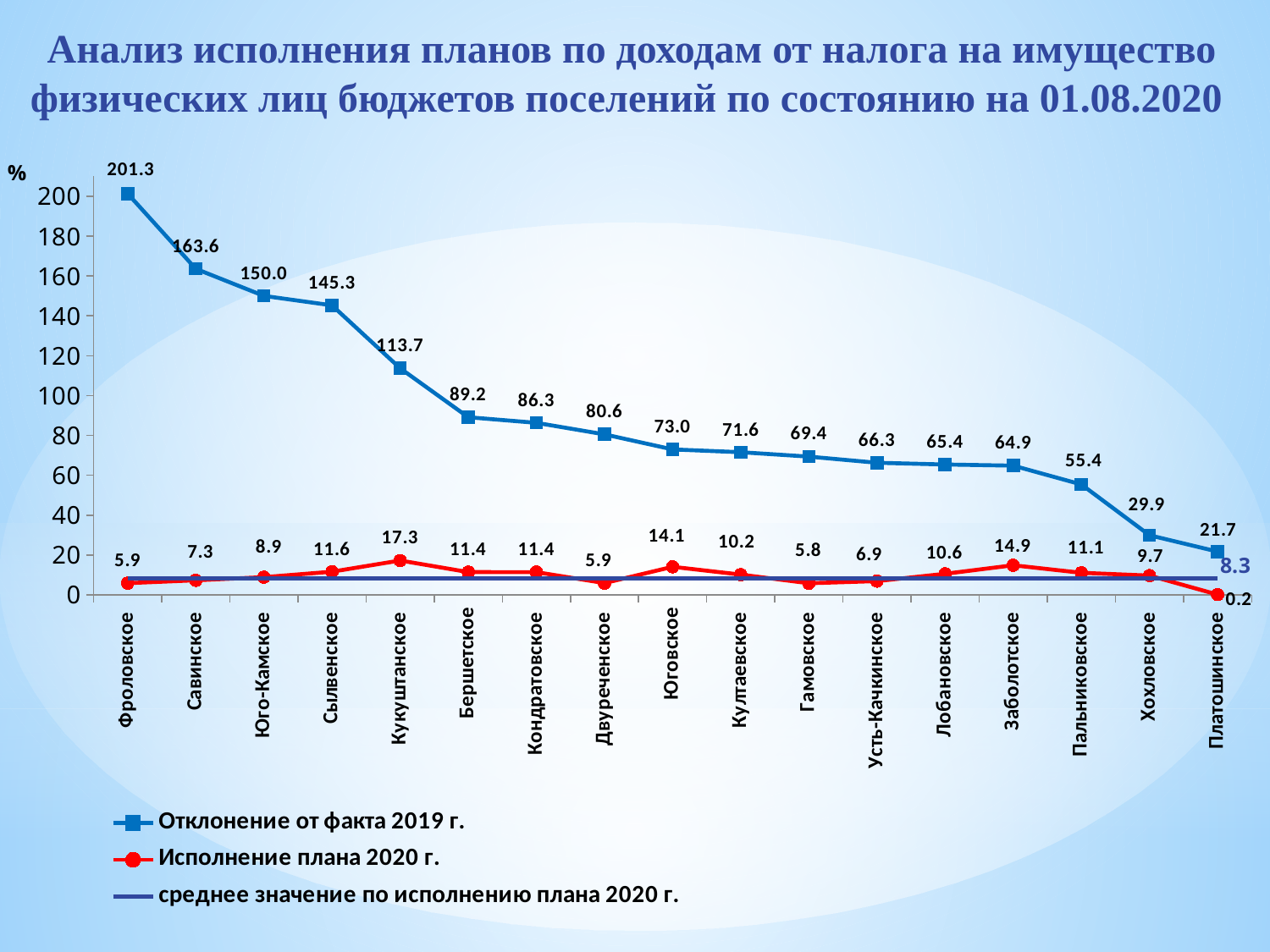
Which settlement has the lowest value for 'Исполнение плана 2020 г.'? Платошинское Which settlement has the highest value for 'Отклонение от факта 2019 г.'? Фроловское Does the 'Отклонение от факта 2019 г.' series rise or fall from left to right along the x axis? fall What is the value of 'среднее значение по исполнению плана 2020 г.'? 8.3 What colour is the line for 'Исполнение плана 2020 г.'? red How many series does the legend list? 3 What is the value of 'Исполнение плана 2020 г.' for Кукуштанское? 17.3 Which is larger for 'Исполнение плана 2020 г.': Юговское or Култаевское? Юговское What is the difference between the 'Отклонение от факта 2019 г.' values for Савинское and Юго-Камское? 13.6 What is the value of 'Отклонение от факта 2019 г.' for Фроловское? 201.3 What type of chart is shown on the slide? line chart How many settlements are plotted along the x axis? 17